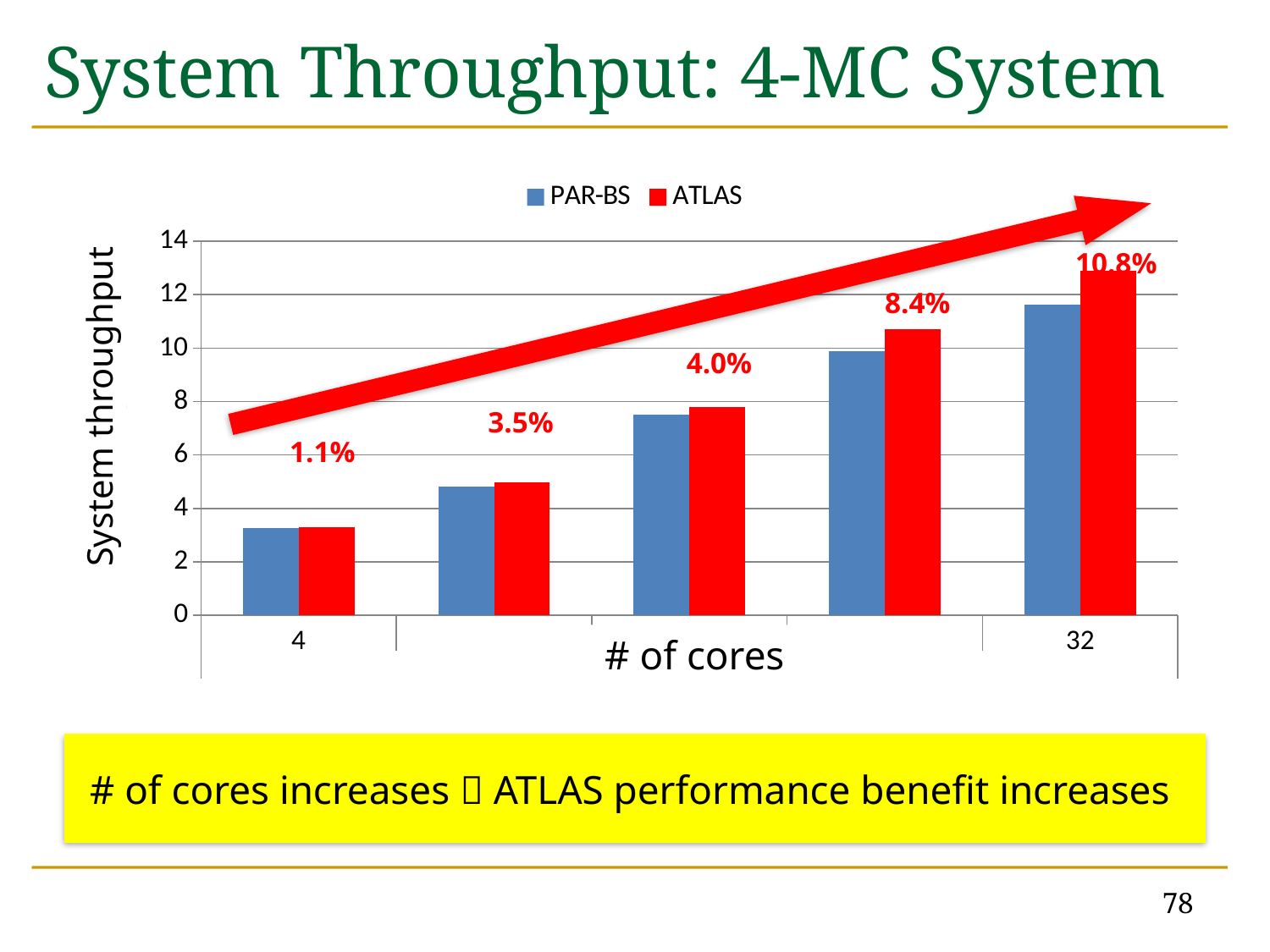
How many series does the legend list? 2 Is the PAR-BS value for 4 cores greater or less than 4? less Which x-axis category has the highest system throughput? 32 What percentage label is printed above the bars for 32 cores? 10.8% Is the ATLAS value for 32 cores greater or less than 12? greater Which x-axis category has the lowest system throughput? 4 At 32 cores, which series has the larger system throughput, PAR-BS or ATLAS? ATLAS What is the label of the y axis? System throughput What are the two series named in the legend? PAR-BS and ATLAS What kind of chart is shown on the slide? bar chart What percentage label is printed above the bars for 4 cores? 1.1% How many groups of bars are plotted along the x axis? 5